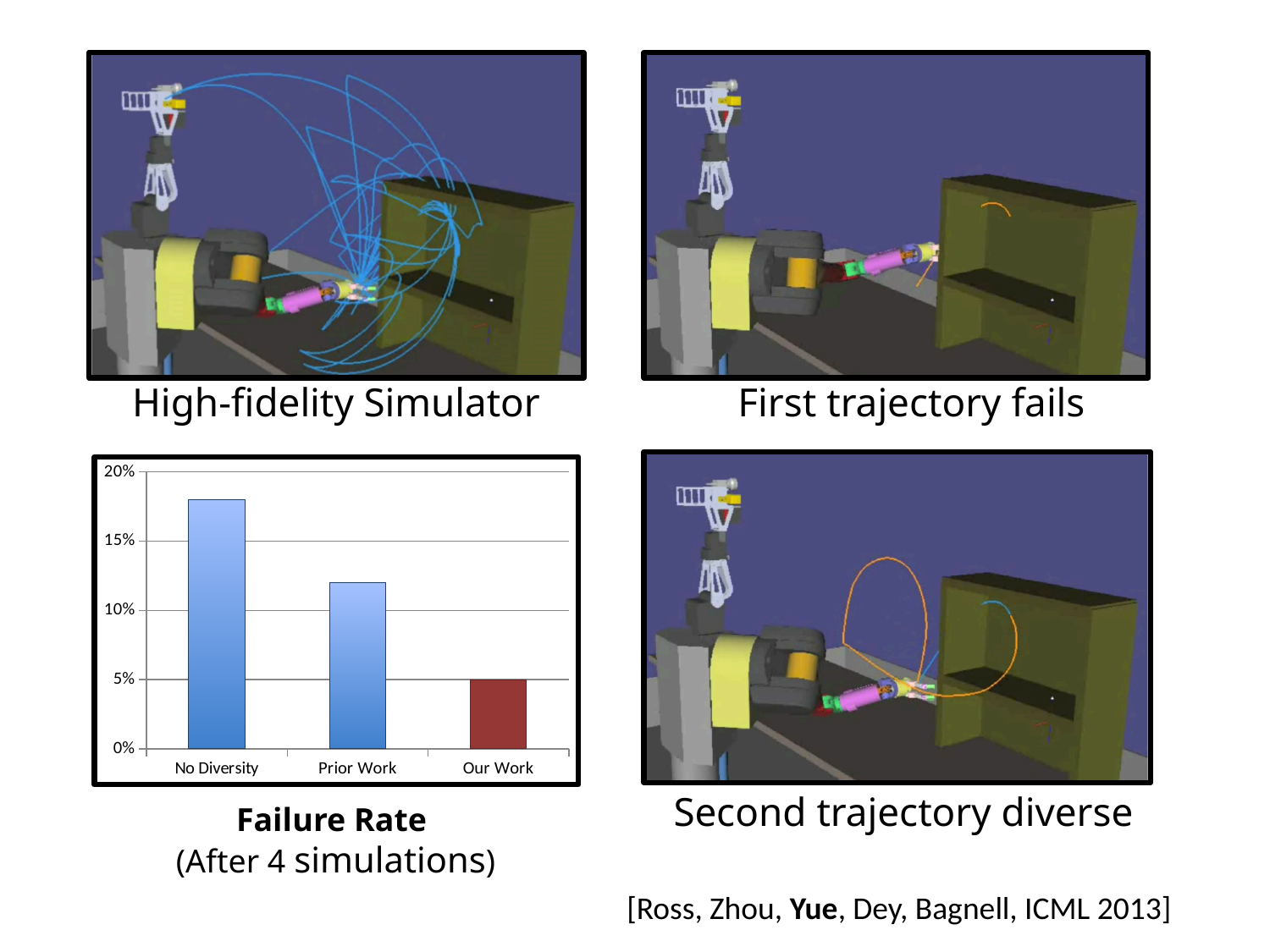
Is the failure rate for Prior Work greater or less than 15%? less Do the failure rates rise or fall from left to right across the categories? fall Which category has the highest failure rate? No Diversity Which bar in the chart is coloured red rather than blue? Our Work Which category has the lowest failure rate? Our Work What kind of chart is shown on the slide? bar chart How many categories are shown on the Failure Rate chart? 3 Is the failure rate for Prior Work greater or less than 10%? greater Which has a higher failure rate, Prior Work or Our Work? Prior Work What is the title given below the bar chart? Failure Rate (After 4 simulations) Is the failure rate for No Diversity greater or less than 15%? greater What is the failure rate for Our Work? 5%